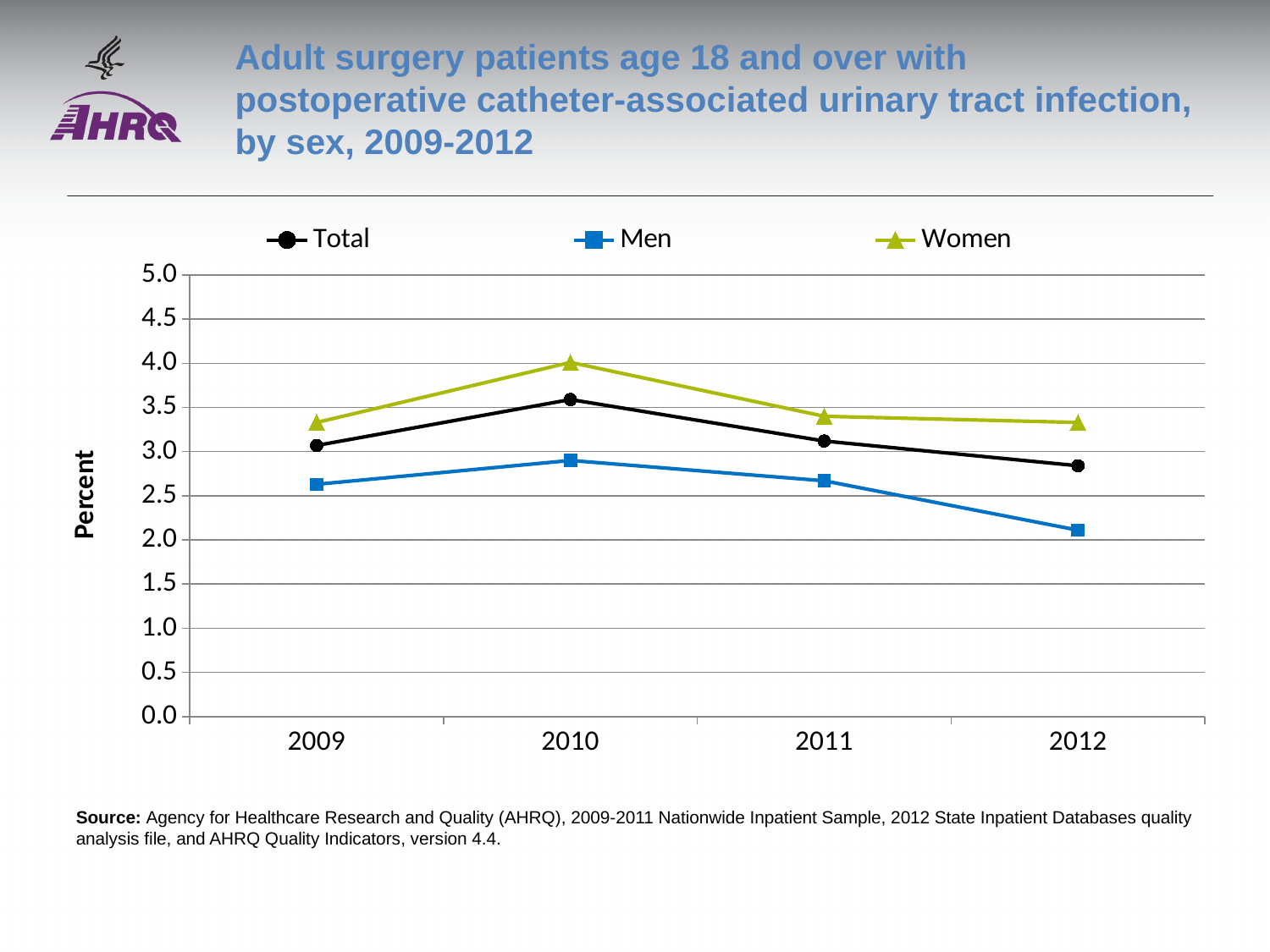
In which year is the Women series at its highest? 2010 Is the value for Women in 2010 greater or less than 3.5? greater How many series does the legend list? 3 Does the Men series rise or fall from 2010 to 2012? fall What kind of chart is shown on the slide? line chart In 2012, which is larger: the value for Women or the value for Men? Women How many years are plotted along the x axis? 4 Which series has the highest value in 2010? Women Is the value for Men in 2012 greater or less than 2.5? less What is the label on the y axis? Percent In which year is the Men series at its lowest? 2012